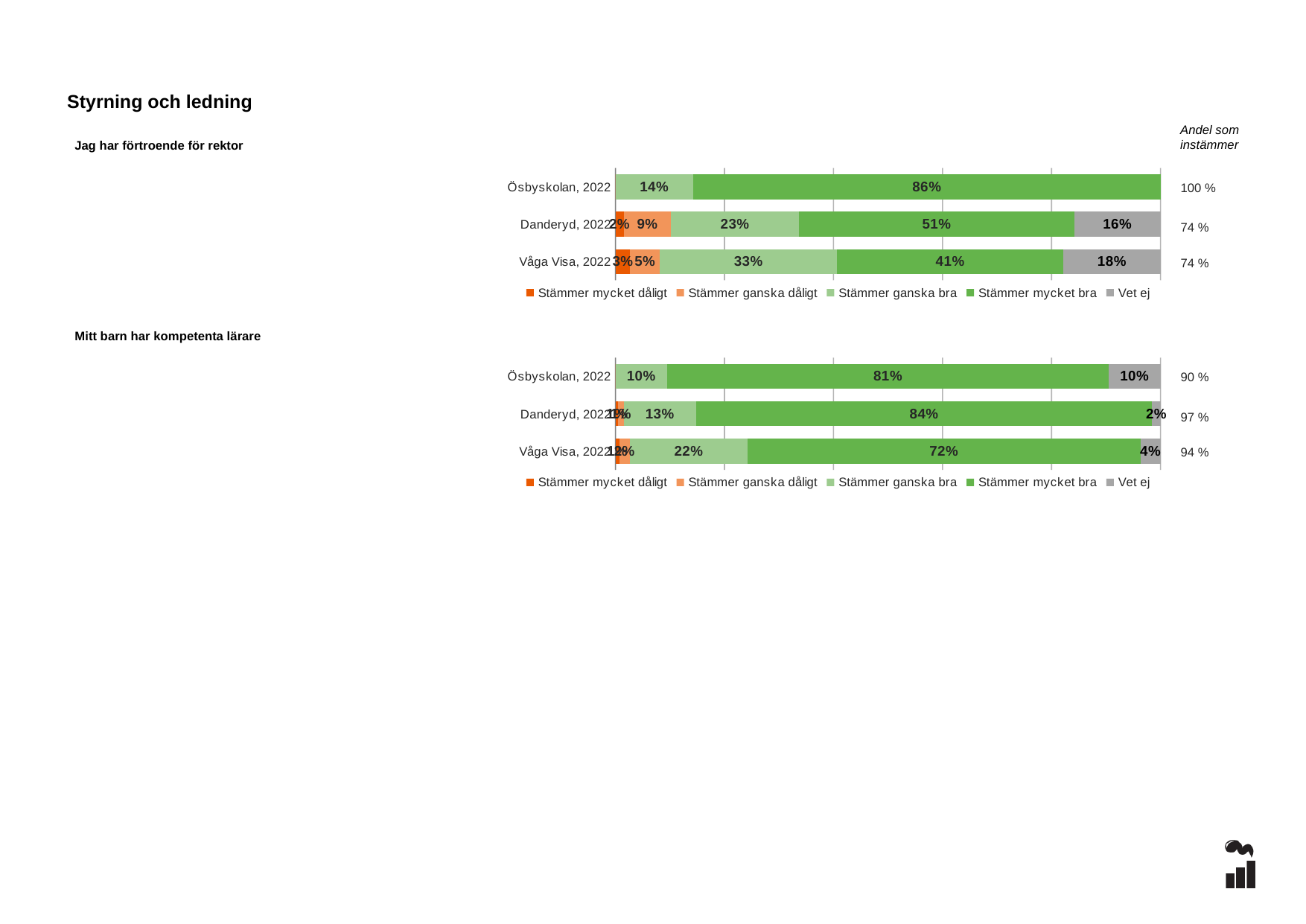
In the chart 'Jag har förtroende för rektor', what is the value of 'Stämmer ganska bra' for Våga Visa, 2022? 33% How many series does the legend of the chart 'Jag har förtroende för rektor' list? 5 In the chart 'Mitt barn har kompetenta lärare', what is the value of 'Stämmer mycket bra' for Våga Visa, 2022? 72% In the chart 'Jag har förtroende för rektor', what is the 'Vet ej' value for Danderyd, 2022? 16% In the chart 'Mitt barn har kompetenta lärare', is the 'Stämmer ganska bra' value larger for Danderyd, 2022 or Våga Visa, 2022? Våga Visa, 2022 What kind of chart is 'Mitt barn har kompetenta lärare'? Stacked bar chart In the chart 'Jag har förtroende för rektor', what is the value of 'Stämmer mycket bra' for Ösbyskolan, 2022? 86% In the chart 'Mitt barn har kompetenta lärare', which row has the lowest 'Stämmer mycket bra' value? Våga Visa, 2022 In the chart 'Jag har förtroende för rektor', what is the difference between the 'Stämmer mycket bra' values for Danderyd, 2022 and Våga Visa, 2022? 10% In the chart 'Mitt barn har kompetenta lärare', what is the 'Andel som instämmer' shown for Danderyd, 2022? 97 % In the chart 'Jag har förtroende för rektor', which row has the highest 'Stämmer mycket bra' value? Ösbyskolan, 2022 In the chart 'Mitt barn har kompetenta lärare', what is the 'Vet ej' value for Ösbyskolan, 2022? 10%